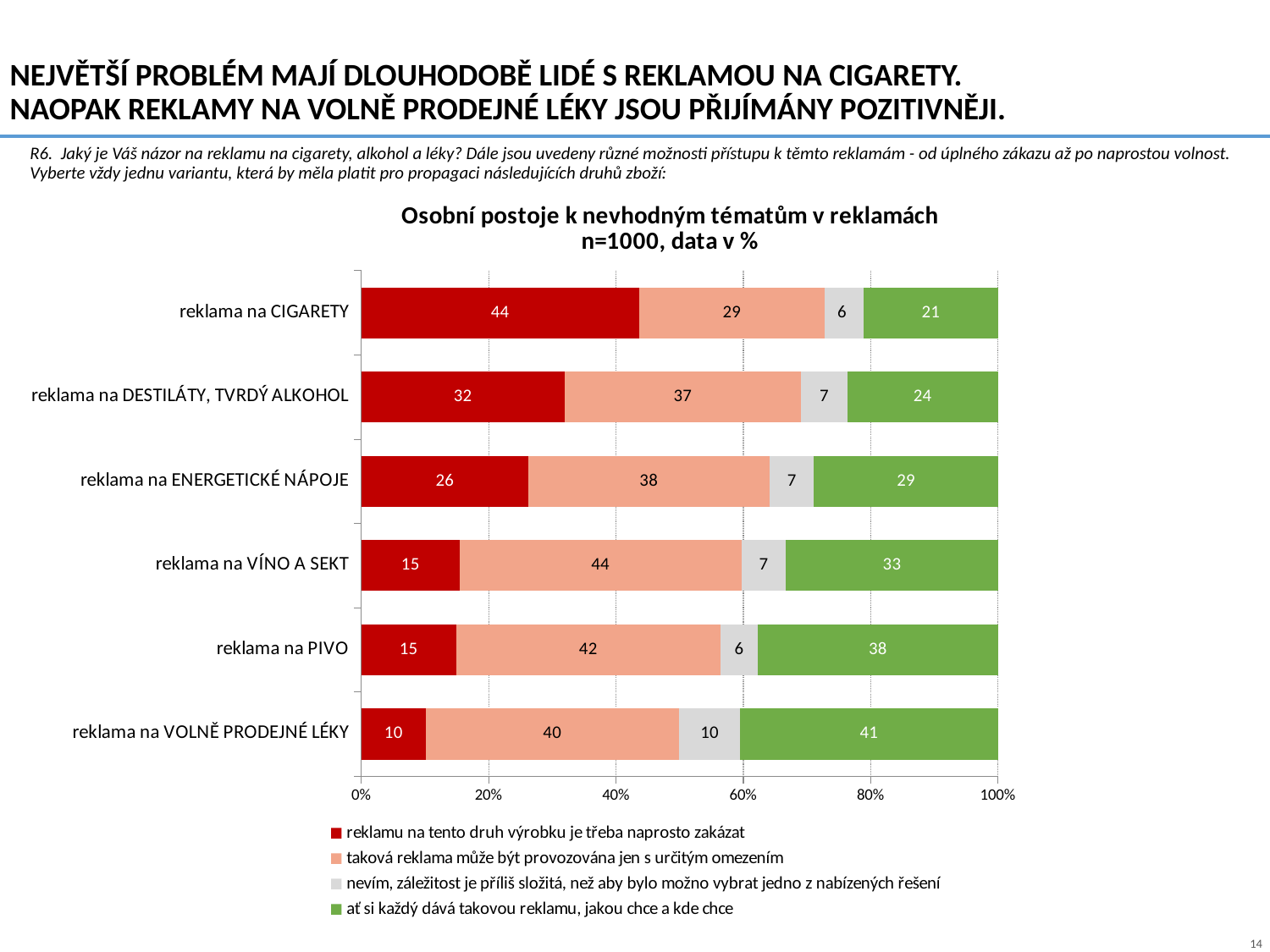
What kind of chart is shown on the slide? stacked bar chart What is the value for "nevím, záležitost je příliš složitá, než aby bylo možno vybrat jedno z nabízených řešení" for reklama na PIVO? 6 What is the total of the stacked bar for reklama na CIGARETY? 100 Which category has the lowest value for "reklamu na tento druh výrobku je třeba naprosto zakázat"? reklama na VOLNĚ PRODEJNÉ LÉKY How many series does the legend list? 4 What is the value for "reklamu na tento druh výrobku je třeba naprosto zakázat" for reklama na CIGARETY? 44 Which has a larger value for "ať si každý dává takovou reklamu, jakou chce a kde chce": reklama na PIVO or reklama na VÍNO A SEKT? reklama na PIVO What is the value for "ať si každý dává takovou reklamu, jakou chce a kde chce" for reklama na VOLNĚ PRODEJNÉ LÉKY? 41 What is the difference between the "naprosto zakázat" values for reklama na CIGARETY and reklama na DESTILÁTY, TVRDÝ ALKOHOL? 12 How many categories are shown in the chart? 6 Which category has the highest value for "reklamu na tento druh výrobku je třeba naprosto zakázat"? reklama na CIGARETY Do the values for "reklamu na tento druh výrobku je třeba naprosto zakázat" rise or fall going from the top category to the bottom category? fall